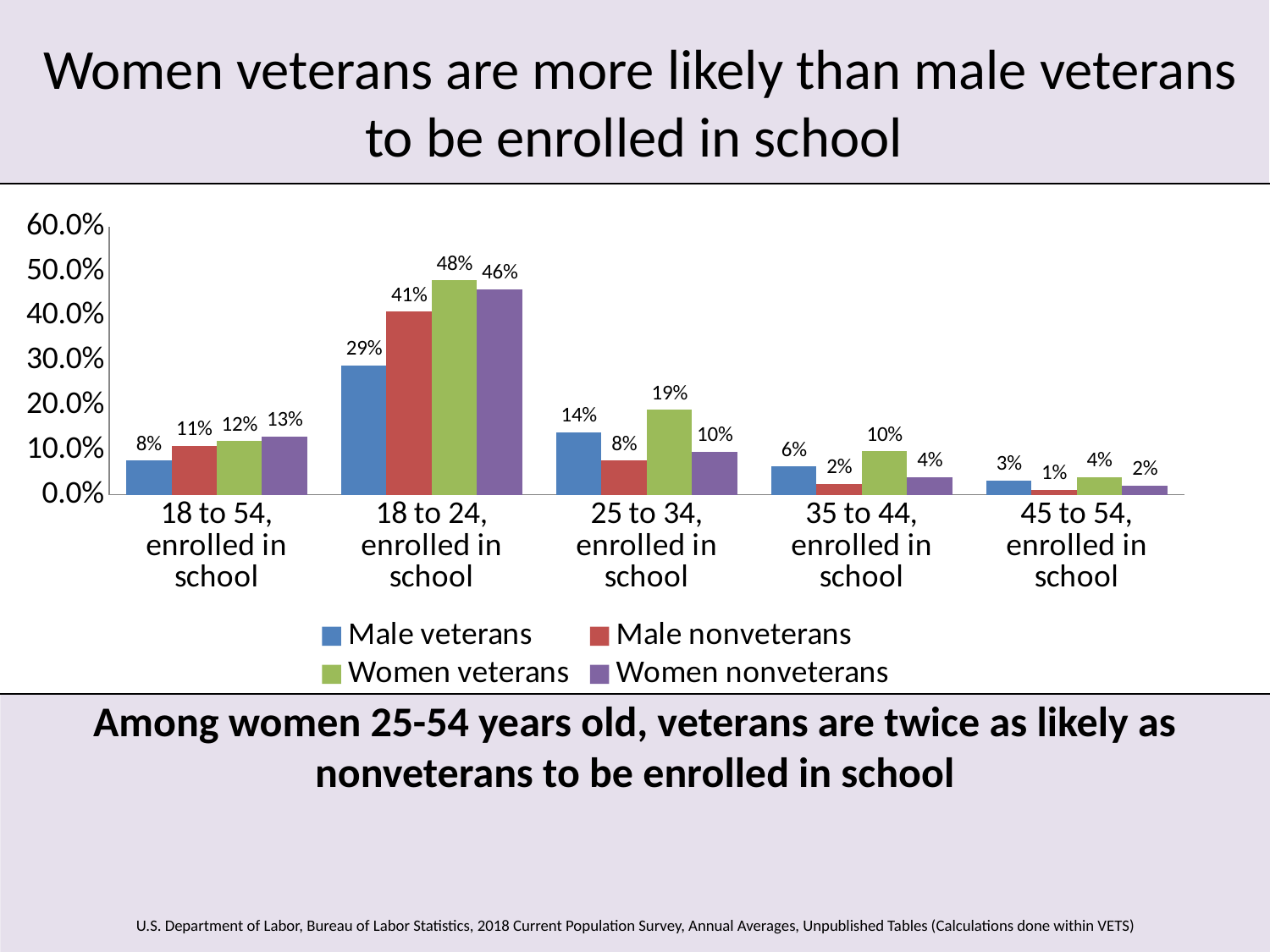
How many series does the legend list? 4 What is the value for Male nonveterans in the 35 to 44, enrolled in school category? 2% Which age category has the lowest value for Male nonveterans? 45 to 54, enrolled in school Which age category has the highest value for Women veterans? 18 to 24, enrolled in school In the 18 to 24, enrolled in school category, which is larger: Women veterans or Male nonveterans? Women veterans What is the value for Women veterans in the 18 to 24, enrolled in school category? 48% What is the value for Male veterans in the 25 to 34, enrolled in school category? 14% Is the value for Male nonveterans in the 18 to 24, enrolled in school category greater or less than 30.0%? greater How many age categories are shown on the x axis? 5 Which series is shown in green in the legend? Women veterans What kind of chart is shown on the slide? Bar chart What is the difference between Women veterans and Male veterans in the 25 to 34, enrolled in school category? 5%